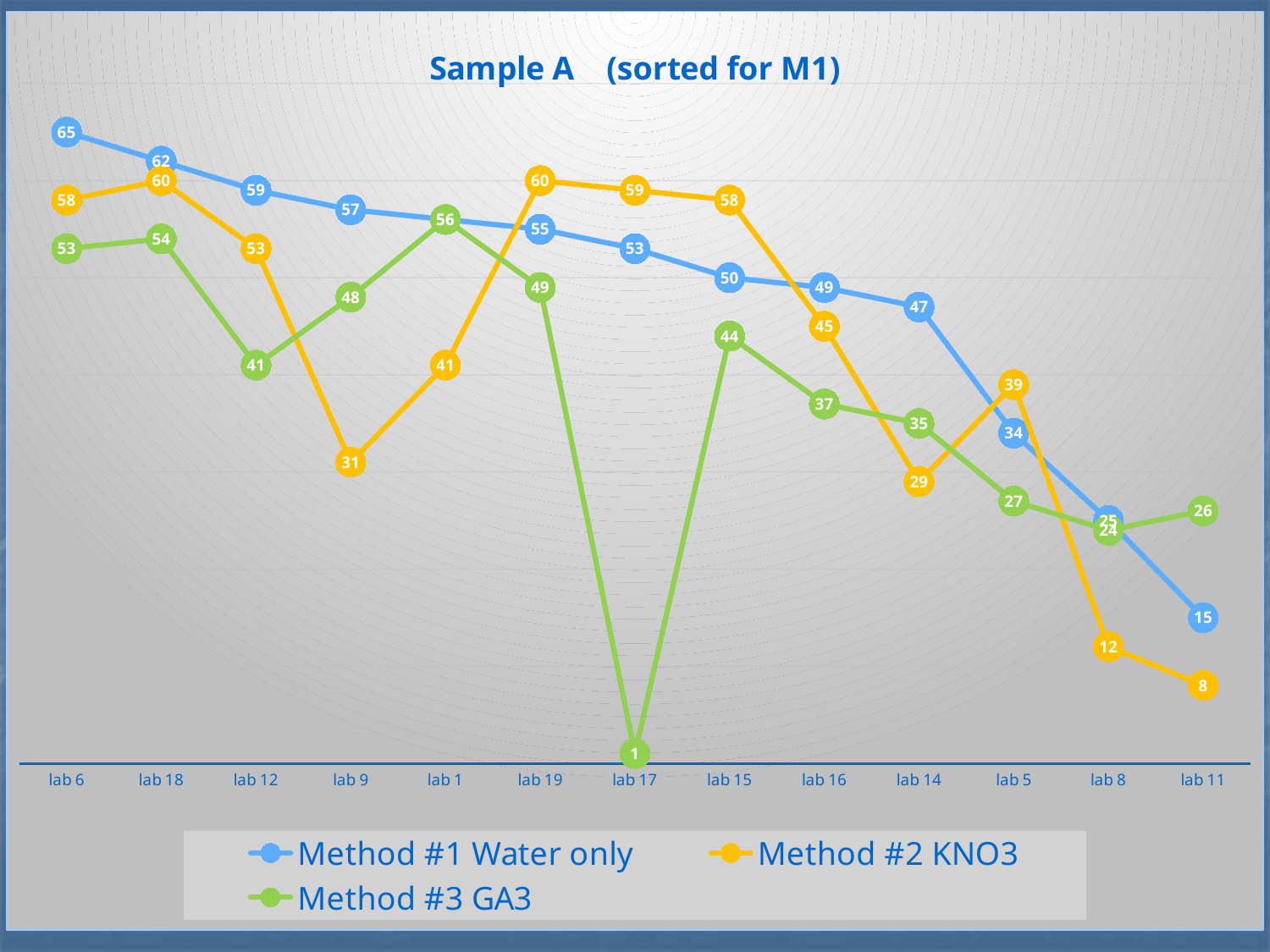
How many series does the legend list? 3 What is the value for Method #2 KNO3 at lab 9? 31 What is the value for Method #1 Water only at lab 6? 65 Which lab has the lowest value for Method #2 KNO3? lab 11 What is the value for Method #2 KNO3 at lab 14? 29 Which lab has the lowest value for Method #3 GA3? lab 17 What kind of chart is shown on the slide? line chart What is the value for Method #3 GA3 at lab 17? 1 What is the difference between Method #1 Water only and Method #2 KNO3 at lab 11? 7 How many labs are shown on the x axis? 13 At lab 15, which is larger: Method #2 KNO3 or Method #3 GA3? Method #2 KNO3 Which lab has the highest value for Method #1 Water only? lab 6